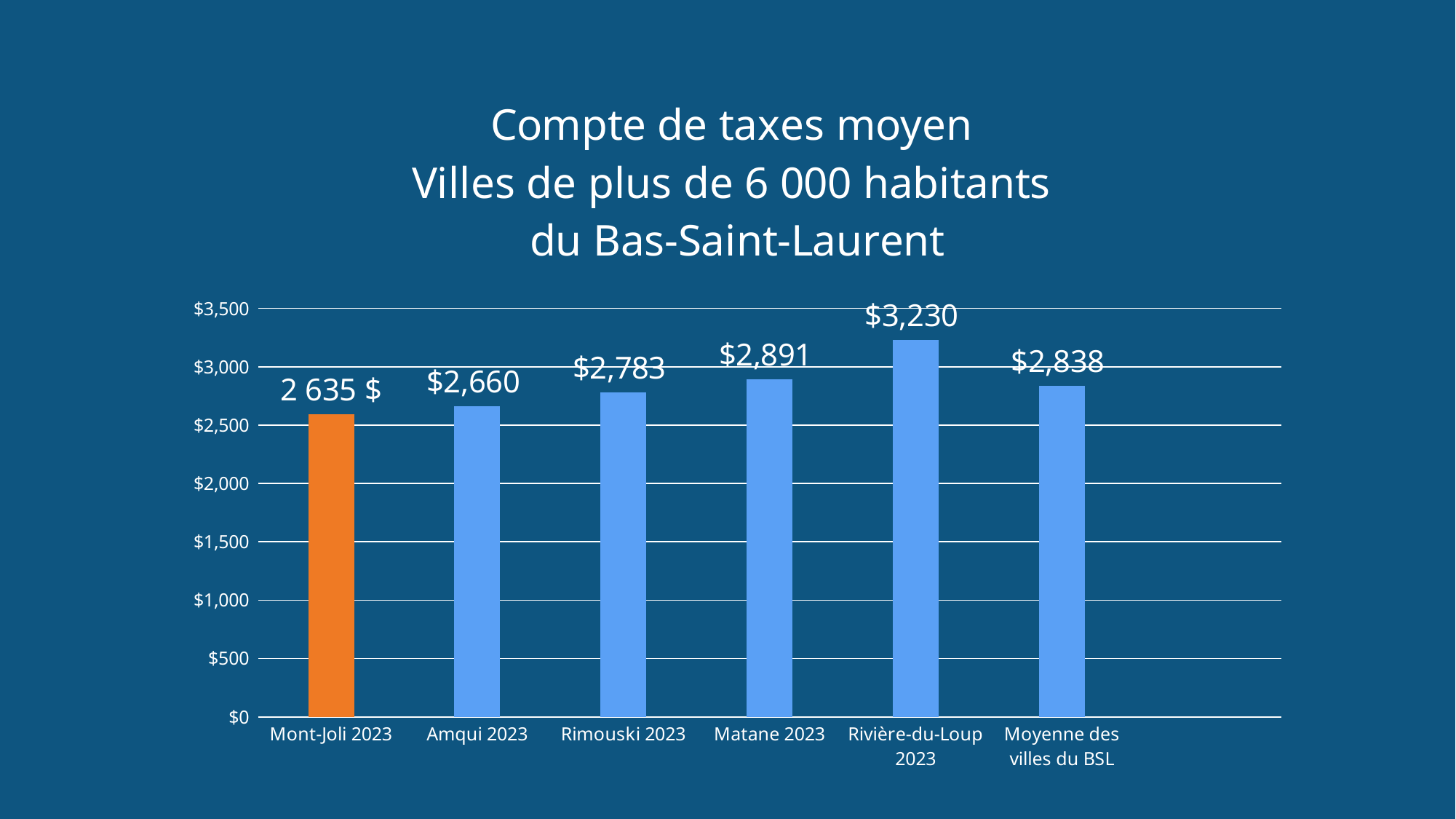
What is the value for Moyenne des villes du BSL? $2,838 What kind of chart is shown on the slide? bar chart How many categories are shown on the x axis? 6 Which category has the lowest value? Mont-Joli 2023 What is the value for Rimouski 2023? $2,783 What is the difference between Rivière-du-Loup 2023 and Amqui 2023? $570 What is the value for Amqui 2023? $2,660 Is the value for Rivière-du-Loup 2023 greater or less than $3,000? greater Which category has the highest value? Rivière-du-Loup 2023 Which is larger, the value for Matane 2023 or the value for Moyenne des villes du BSL? Matane 2023 What is the value for Mont-Joli 2023? 2 635 $ What is the value for Matane 2023? $2,891